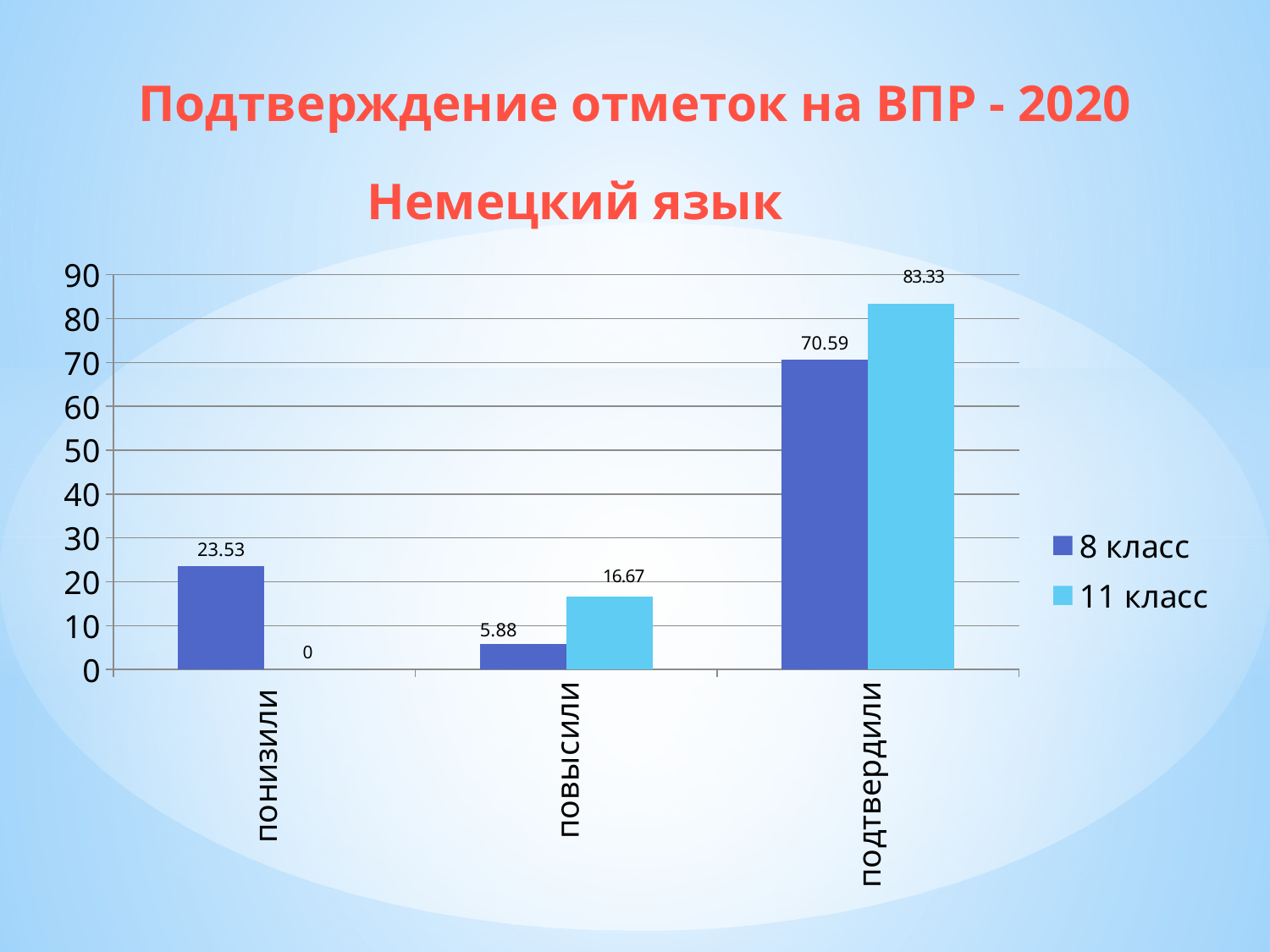
What is the value for 11 класс in the подтвердили category? 83.33 What is the value for 11 класс in the понизили category? 0 How many series does the legend list? 2 Which category has the highest value for 8 класс? подтвердили What is the difference between the 11 класс and 8 класс values in the подтвердили category? 12.74 Is the value for 8 класс in the подтвердили category greater or less than 60? greater What is the value for 11 класс in the повысили category? 16.67 Which category has the lowest value for 8 класс? повысили What is the value for 8 класс in the понизили category? 23.53 How many categories are shown on the x axis? 3 In the повысили category, which series has the larger value, 8 класс or 11 класс? 11 класс What kind of chart is shown on the slide? bar chart